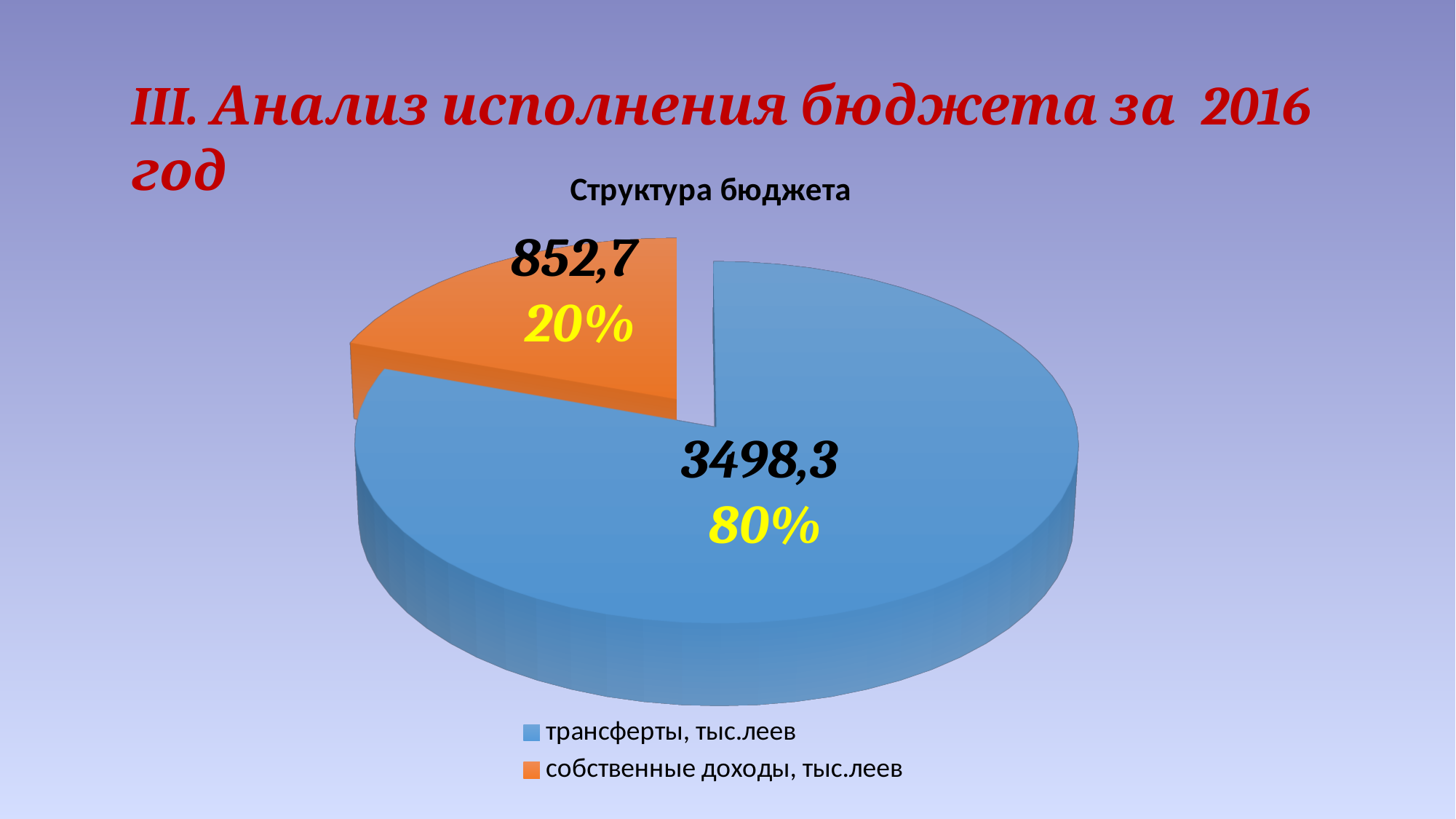
What kind of chart is shown on the slide? pie chart What is the value for трансферты, тыс.леев? 3498,3 What share of the pie does собственные доходы, тыс.леев represent? 20% What is the value for собственные доходы, тыс.леев? 852,7 Which is larger: трансферты, тыс.леев or собственные доходы, тыс.леев? трансферты, тыс.леев Which category has the smallest slice of the pie? собственные доходы, тыс.леев What colour is the slice for собственные доходы, тыс.леев? orange Which category has the largest slice of the pie? трансферты, тыс.леев What is the difference between the values for трансферты, тыс.леев and собственные доходы, тыс.леев? 2645,6 How many slices does the pie chart have? 2 What share of the pie does трансферты, тыс.леев represent? 80% What is the title of the chart? Структура бюджета